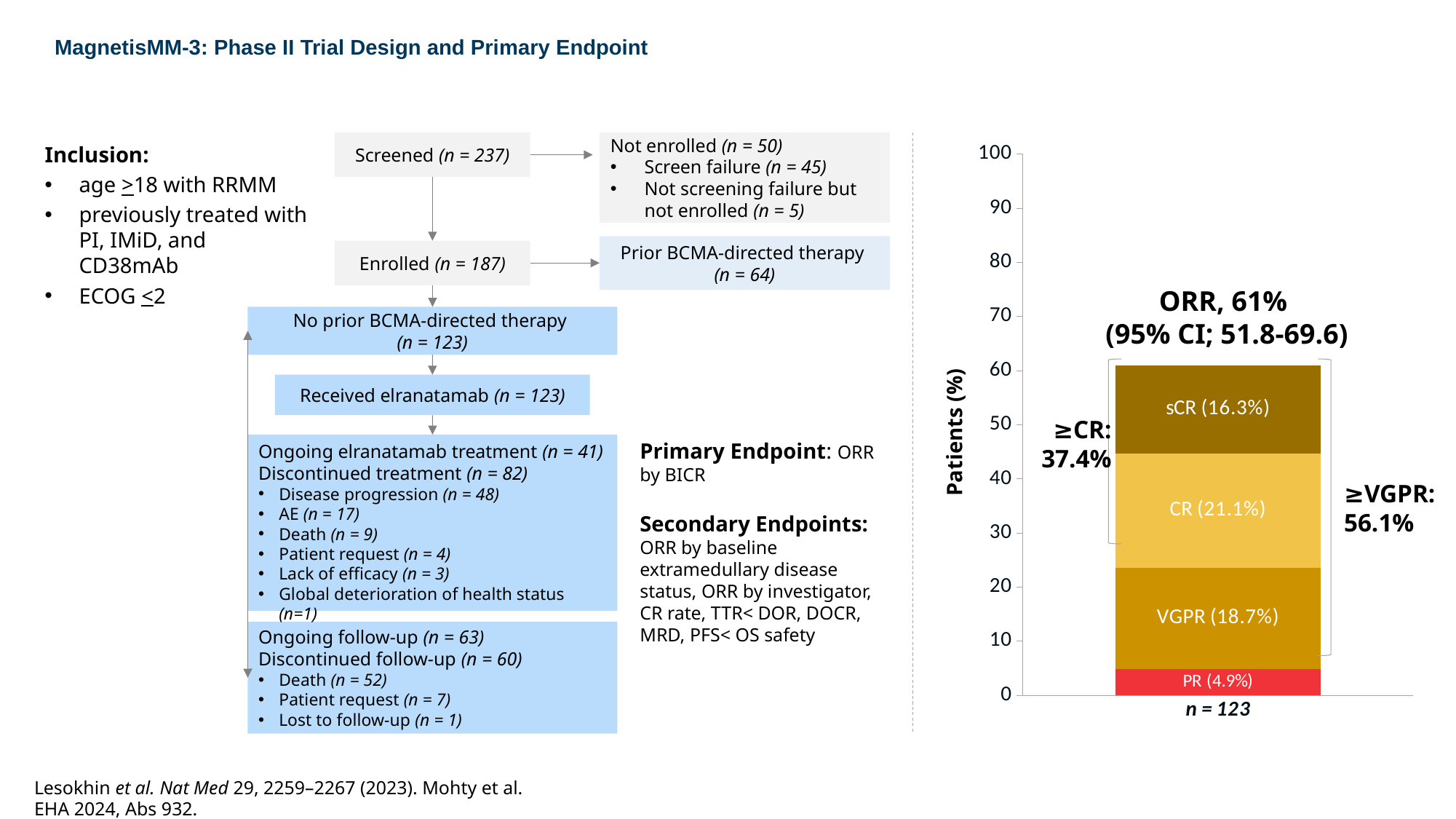
How many response categories are stacked in the bar? 4 What percentage of patients achieved CR in the stacked bar chart? 21.1% Which response category has the smallest segment in the stacked bar? PR Which is larger in the stacked bar, the VGPR segment or the PR segment? VGPR What percentage of patients achieved sCR in the stacked bar chart? 16.3% What is the overall response rate (ORR) shown above the stacked bar? 61% Which response category has the largest segment in the stacked bar? CR What is the label of the y-axis of the chart? Patients (%) What type of chart is shown on the right side of the slide? Stacked bar chart What percentage of patients achieved VGPR in the stacked bar chart? 18.7% What is the difference between the CR and sCR percentages in the stacked bar? 4.8% What percentage of patients achieved PR in the stacked bar chart? 4.9%